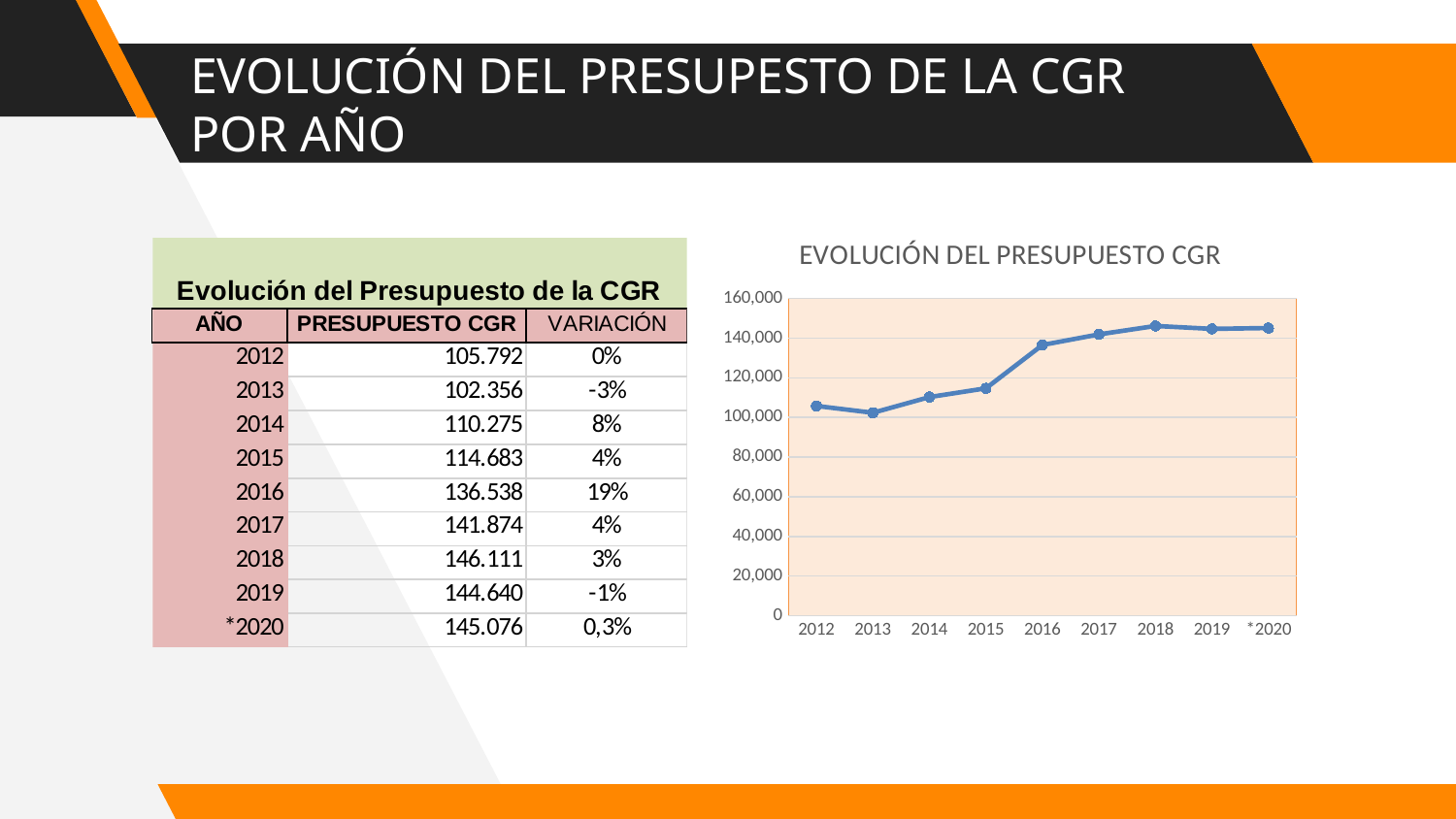
Which year has the lowest value in the chart? 2013 What is the title of the chart on the slide? EVOLUCIÓN DEL PRESUPUESTO CGR Is the value for 2013 in the chart greater or less than 120,000? less Is the value for 2015 in the chart greater or less than 120,000? less How many years are plotted on the x axis of the chart? 9 What is the highest tick value shown on the y axis of the chart? 160,000 Which is larger in the chart, the value for 2016 or the value for 2015? 2016 Between 2015 and 2016, does the plotted value rise or fall? rise Between 2012 and 2013, does the plotted value rise or fall? fall Is the value for 2016 in the chart greater or less than 120,000? greater What kind of chart is shown on the slide? line chart